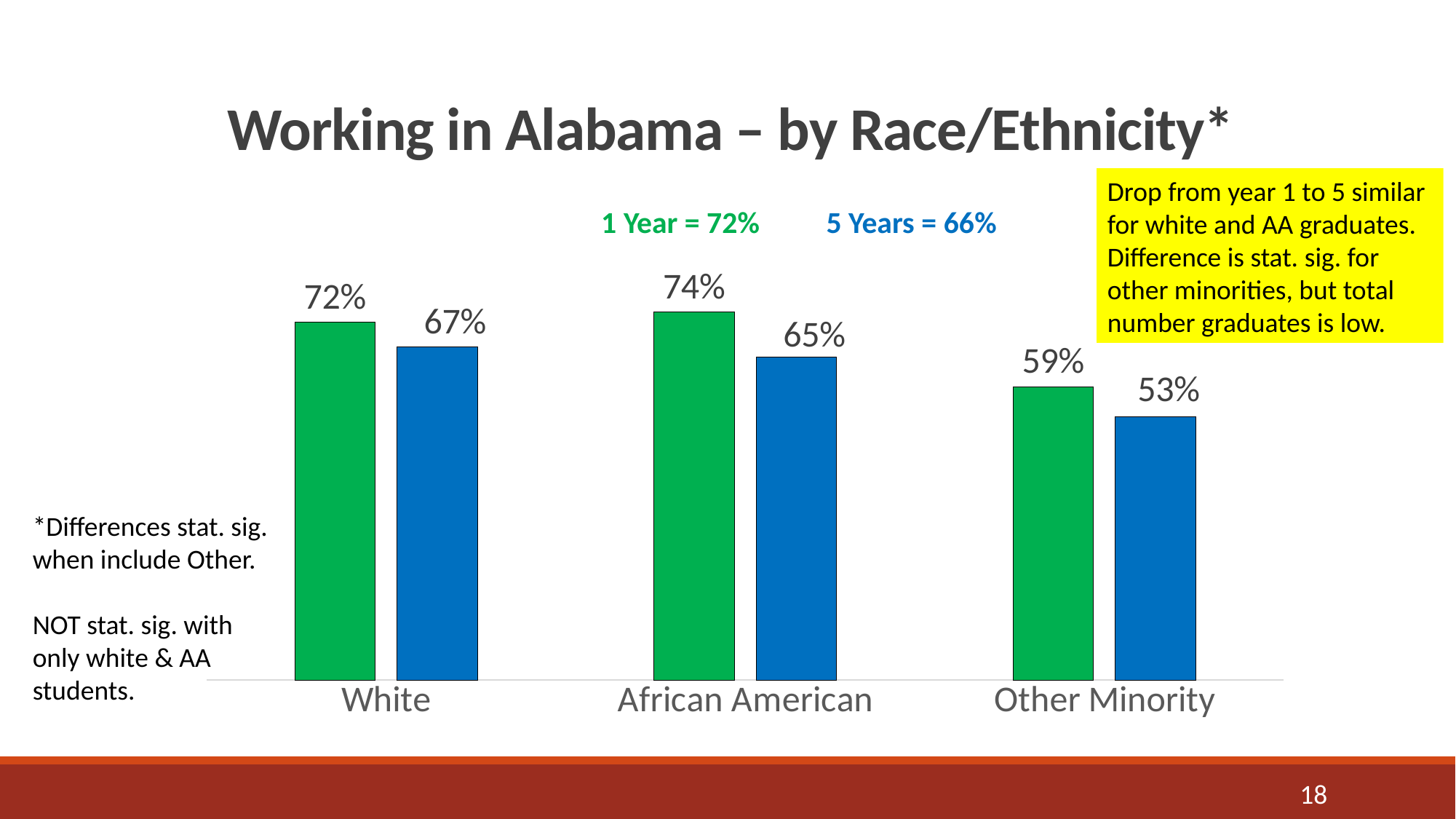
What is the 5 Years value for African American? 65% What is the 5 Years value for Other Minority? 53% Which category has the highest 1 Year value? African American What is the difference between the 1 Year and 5 Years values for Other Minority? 6% What colour are the 1 Year bars? Green What is the difference between the 1 Year and 5 Years values for African American? 9% How many race/ethnicity categories are shown on the x axis? 3 What is the 1 Year value for White? 72% Which category has the lowest 5 Years value? Other Minority What is the 1 Year value for Other Minority? 59% What kind of chart is shown on the slide? Bar chart Which is larger, the 5 Years value for White or the 5 Years value for African American? White